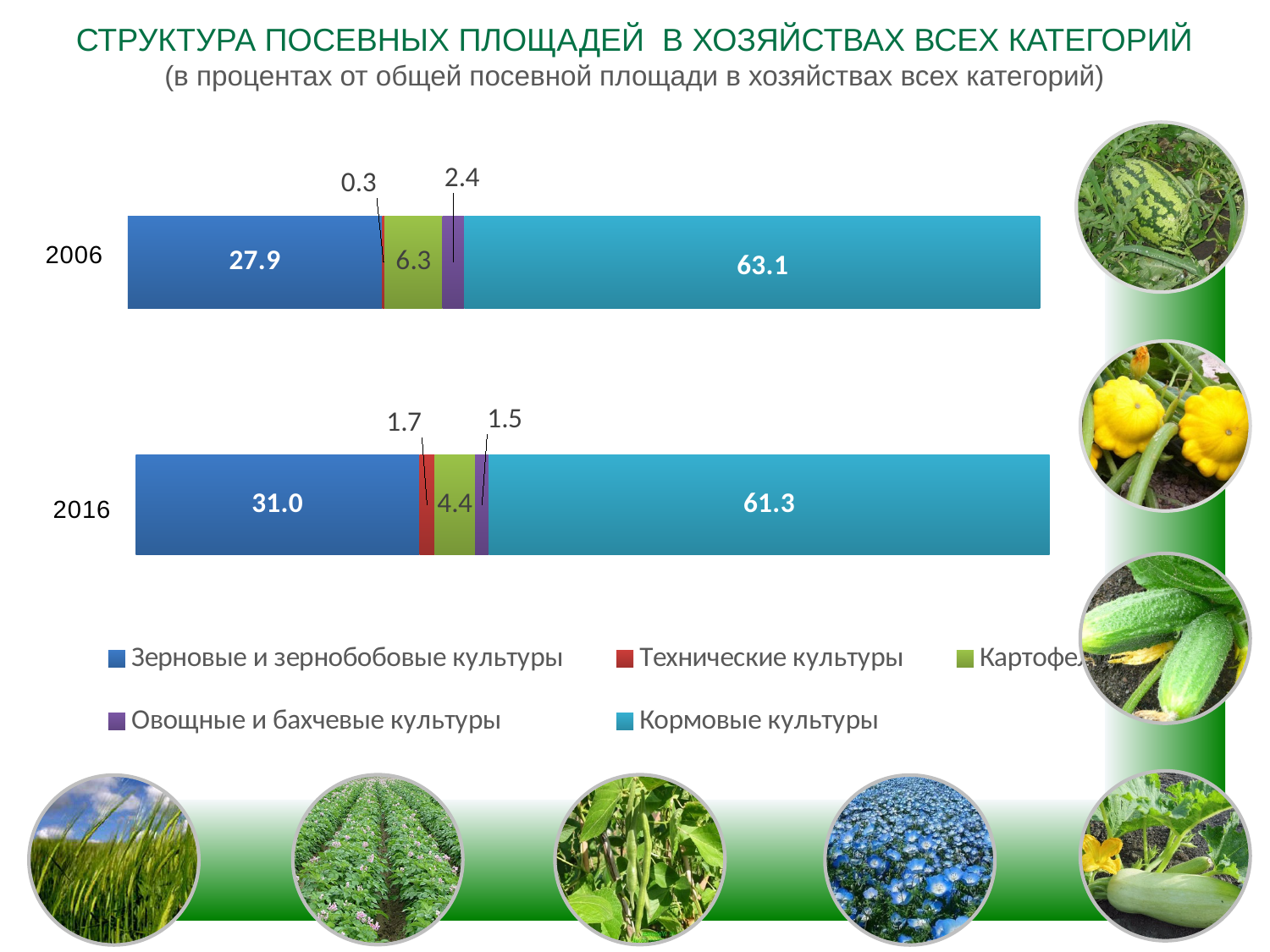
By how much did the value for Зерновые и зернобобовые культуры increase from 2006 to 2016? 3.1 Which series has the smallest segment in the 2006 bar? Технические культуры How many years (bars) are shown in the chart? 2 How many series does the legend list? 5 What is the difference between the Кормовые культуры values for 2006 and 2016? 1.8 Which series has the largest segment in the 2006 bar? Кормовые культуры What kind of chart is shown on the slide? Stacked bar chart What is the value for Кормовые культуры in 2016? 61.3 What is the value for Овощные и бахчевые культуры in 2016? 1.5 Which year has the larger value for Технические культуры, 2006 or 2016? 2016 What is the value for Зерновые и зернобобовые культуры in 2006? 27.9 What is the value for Технические культуры in 2006? 0.3